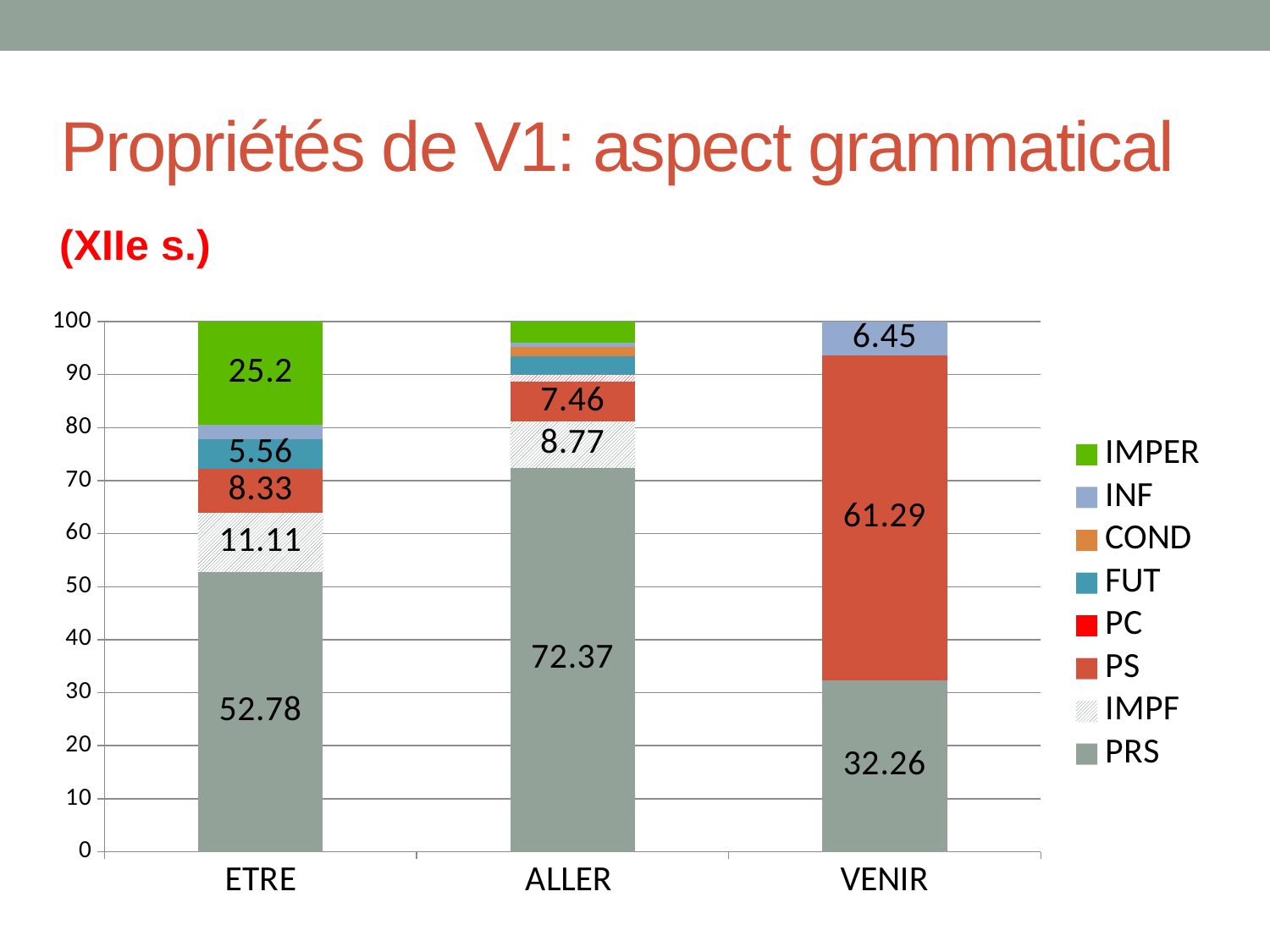
What is the INF value for VENIR? 6.45 What is the difference between the PRS values for ALLER and ETRE? 19.59 What type of chart is shown on the slide? stacked bar chart What is the PS value for VENIR? 61.29 How many series does the legend list? 8 What is the IMPF value for ETRE? 11.11 Which category has the lowest PRS value? VENIR What is the IMPER value for ETRE? 25.2 What is the PRS value for ALLER? 72.37 How many categories are shown on the x axis? 3 Which category has the highest PRS value? ALLER Is the PS value larger for VENIR or for ETRE? VENIR